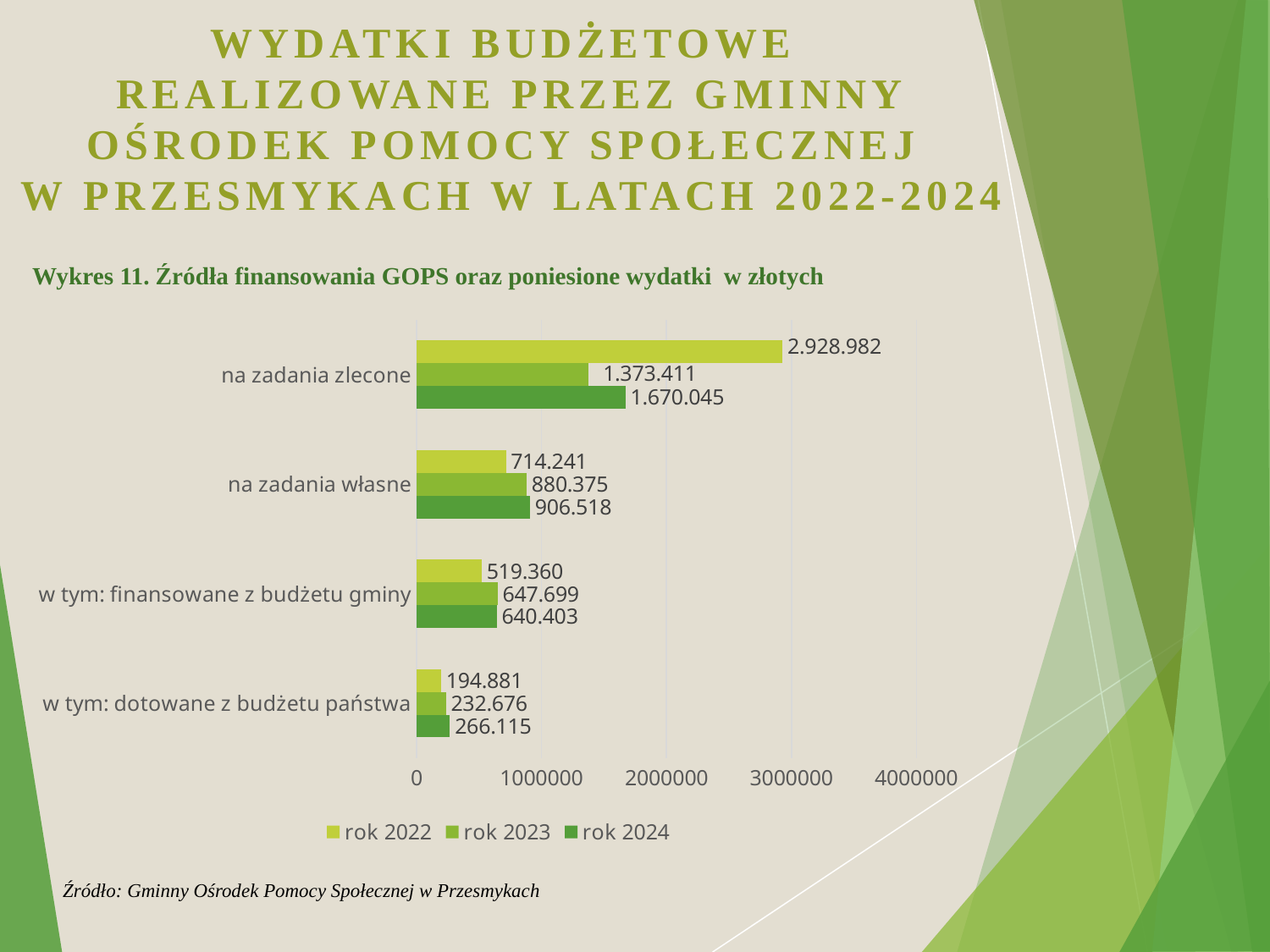
What is the difference between the 'rok 2022' and 'rok 2023' values for 'na zadania zlecone'? 1.555.571 How many categories are shown on the chart? 4 For 'na zadania zlecone', which is larger: the 'rok 2023' value or the 'rok 2024' value? rok 2024 What kind of chart is shown on the slide? bar chart What is the difference between the 'rok 2024' and 'rok 2022' values for 'w tym: dotowane z budżetu państwa'? 71.234 Which category has the lowest value in the series 'rok 2022'? w tym: dotowane z budżetu państwa What is the value for 'w tym: finansowane z budżetu gminy' in the series 'rok 2022'? 519.360 Which category has the highest value in the series 'rok 2024'? na zadania zlecone How many series does the legend list? 3 What is the value for 'na zadania zlecone' in the series 'rok 2022'? 2.928.982 What is the value for 'w tym: dotowane z budżetu państwa' in the series 'rok 2023'? 232.676 What is the value for 'na zadania własne' in the series 'rok 2024'? 906.518